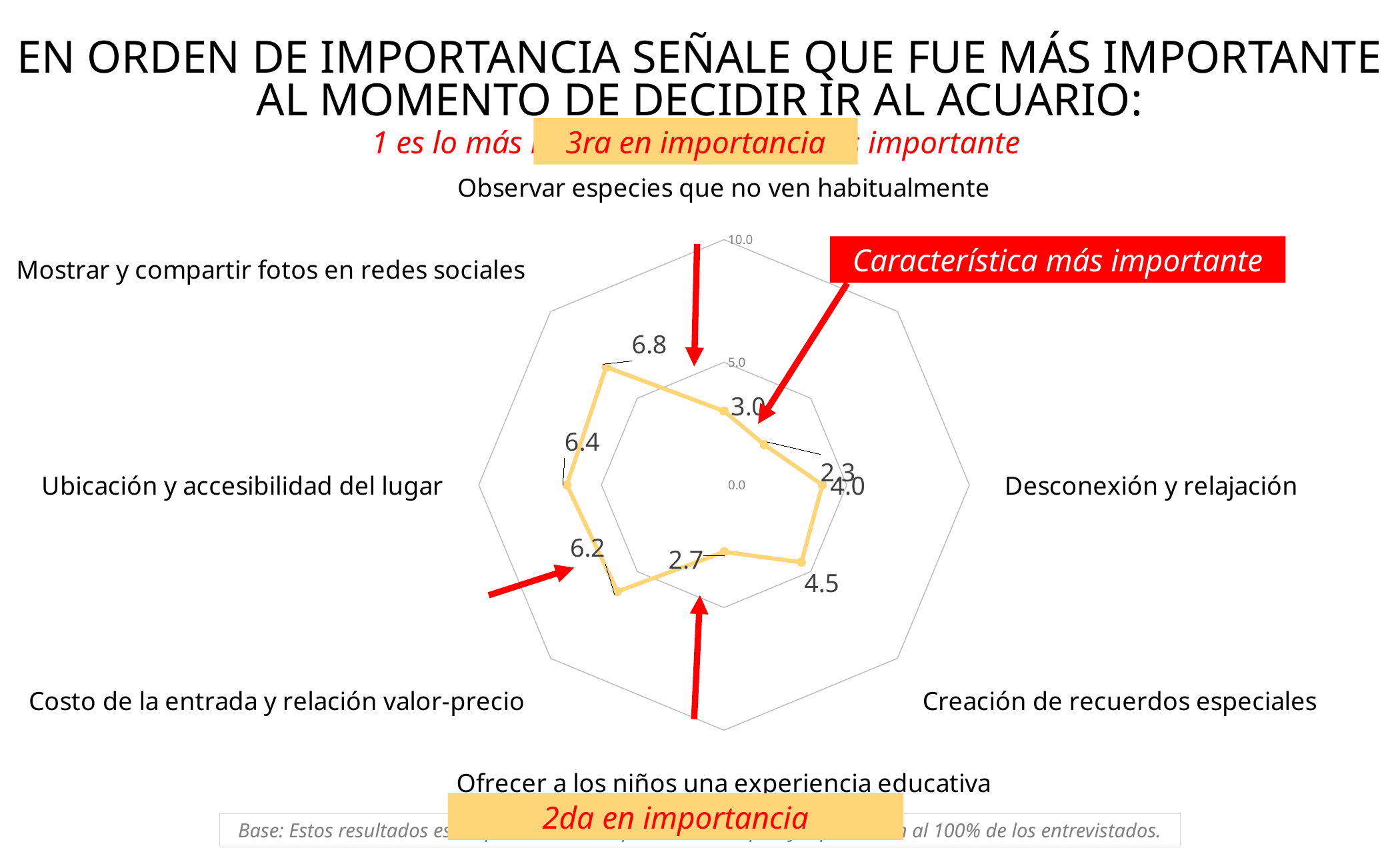
Which has a larger value, "Ubicación y accesibilidad del lugar" or "Costo de la entrada y relación valor-precio"? Ubicación y accesibilidad del lugar Which category has the highest value on the chart? Mostrar y compartir fotos en redes sociales What is the value for "Desconexión y relajación"? 4.0 What is the value for "Observar especies que no ven habitualmente"? 3.0 How many axes (categories) does the radar chart have? 8 What is the value for "Mostrar y compartir fotos en redes sociales"? 6.8 What is the value for "Ofrecer a los niños una experiencia educativa"? 2.7 What is the maximum value shown on the chart's axis scale? 10.0 What is the difference between the values for "Mostrar y compartir fotos en redes sociales" and "Observar especies que no ven habitualmente"? 3.8 Is the value for "Ubicación y accesibilidad del lugar" greater or less than 5.0? greater What is the value for "Creación de recuerdos especiales"? 4.5 What kind of chart is shown on the slide? Radar chart